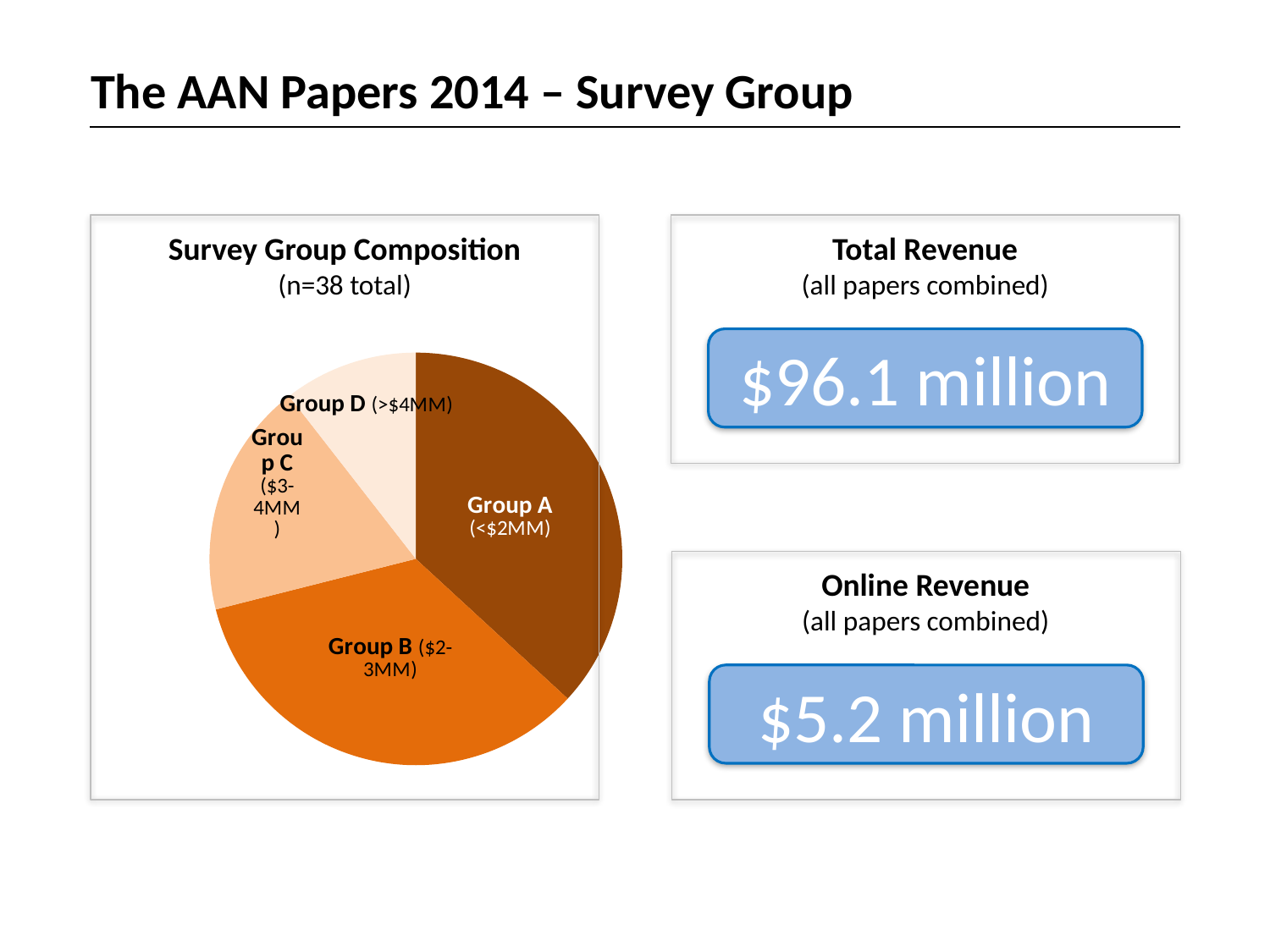
Which group has the smallest slice in the Survey Group Composition pie chart? Group D What kind of chart is shown under the title "Survey Group Composition"? pie chart In the Survey Group Composition pie chart, which slice is larger, Group A or Group C? Group A In the Survey Group Composition pie chart, which slice is larger, Group C or Group D? Group C What revenue range is given for Group B in the Survey Group Composition pie chart? $2-3MM How many groups (slices) does the Survey Group Composition pie chart show? 4 In the Survey Group Composition pie chart, which slice is larger, Group B or Group D? Group B What is the total number of papers (n) stated in the Survey Group Composition chart title? 38